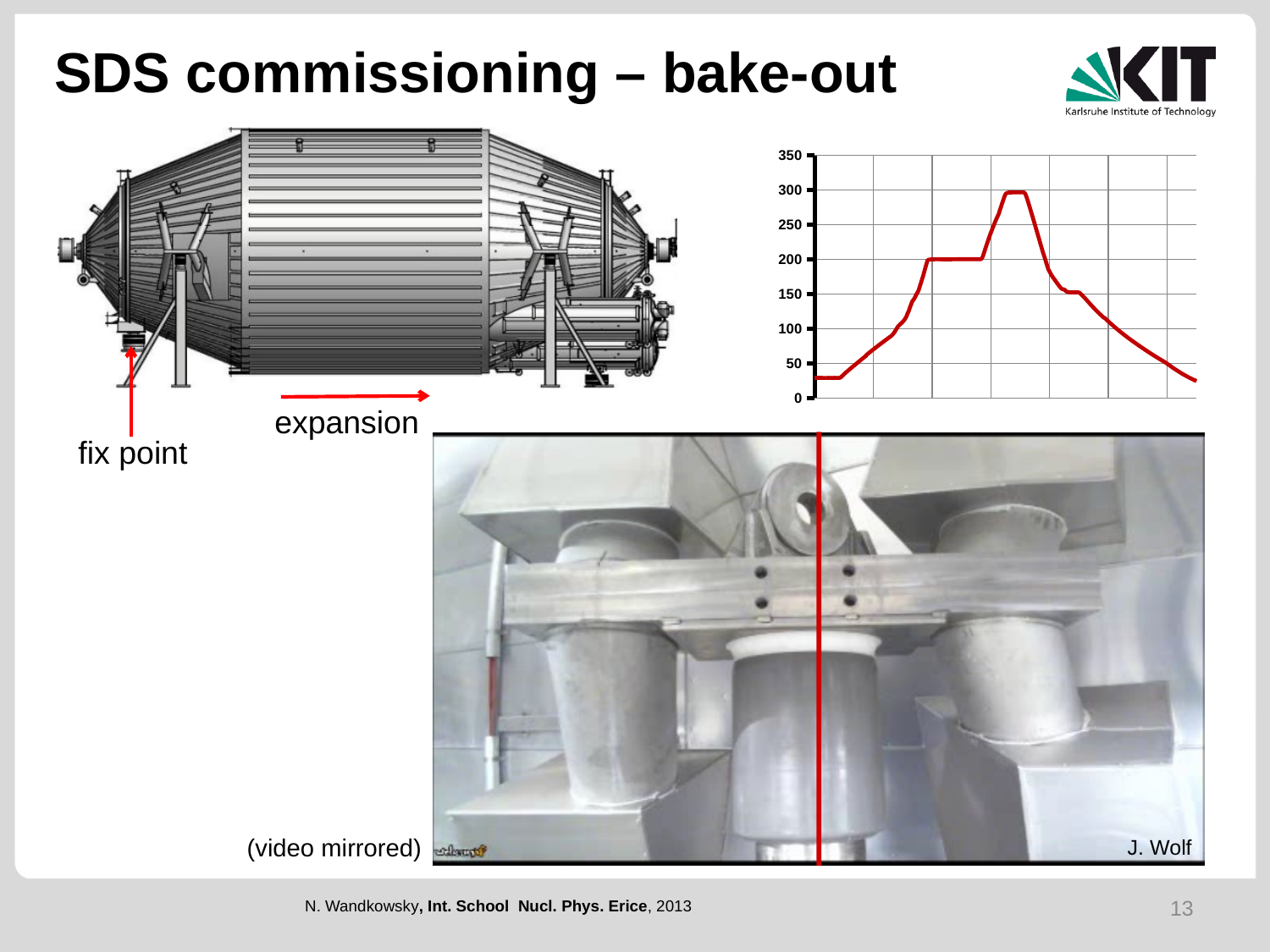
What is the highest value shown on the y axis of the chart? 350 Is the value at the start of the red line greater or less than 50? less How many lines are plotted in the chart? 1 What kind of chart is shown on the slide? line chart What colour is the plotted line in the chart? red Is the peak value of the red line greater or less than 250? greater Is the peak value of the red line greater or less than 350? less Does the red line rise or fall over the last part of the x axis? fall Does the red line rise or fall over the first part of the x axis, before the peak? rise